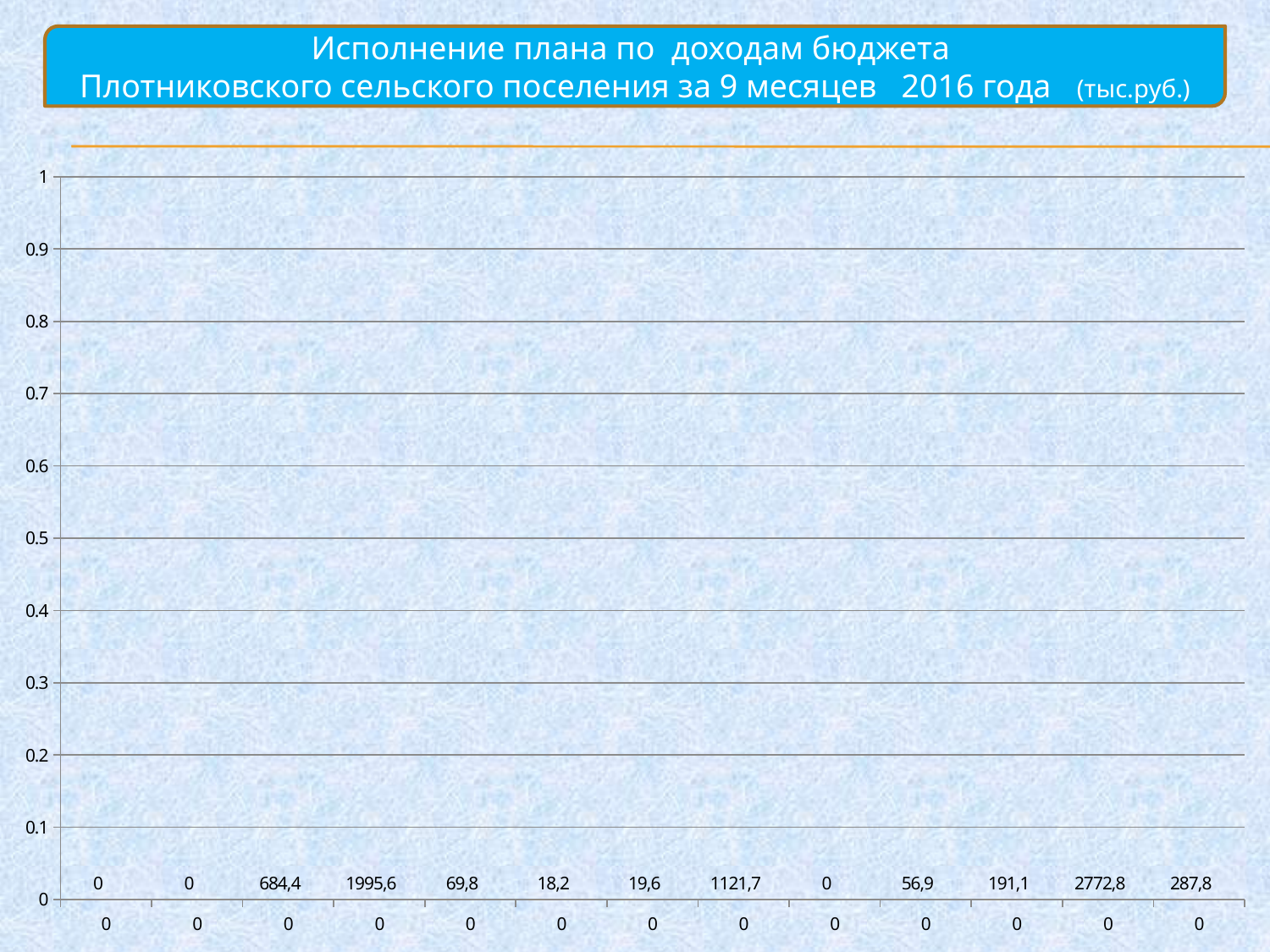
What is the rightmost data label printed along the bottom of the chart? 287,8 How many of the data labels printed along the bottom of the chart are 0? 3 What is the highest value shown on the y axis of the chart? 1 Which is larger among the printed data labels, 1995,6 or 1121,7? 1995,6 What unit is stated in the chart title? тыс.руб. What is the difference between the printed data labels 2772,8 and 1995,6? 777,2 How many category positions are shown along the x axis of the chart? 13 What is the fourth data label from the left printed along the bottom of the chart? 1995,6 What is the largest data label printed along the bottom of the chart? 2772,8 What is the title of the chart on the slide? Исполнение плана по доходам бюджета Плотниковского сельского поселения за 9 месяцев 2016 года (тыс.руб.) What is the smallest non-zero data label printed along the bottom of the chart? 18,2